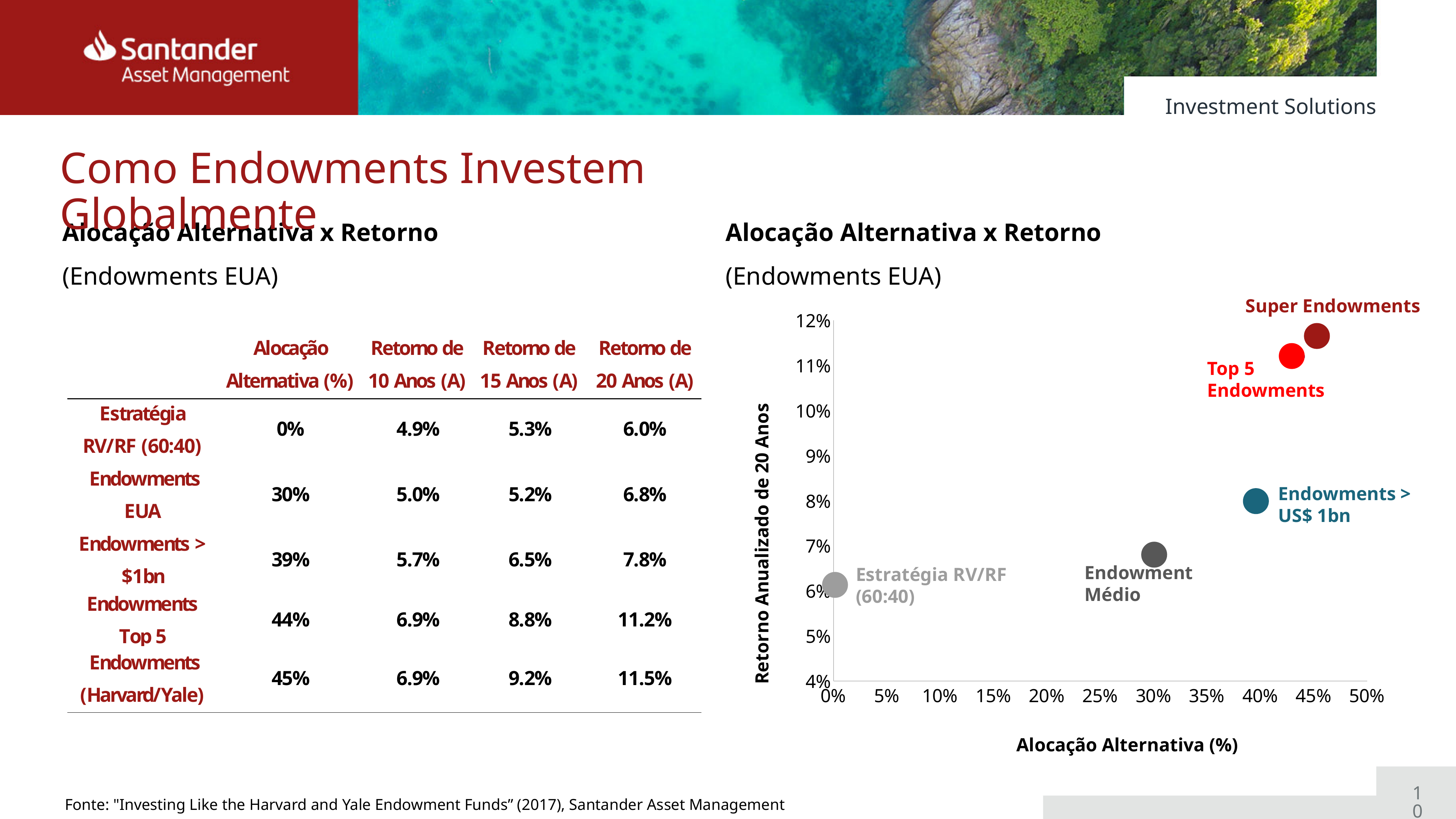
What is the title of the vertical axis of the scatter chart? Retorno Anualizado de 20 Anos In the scatter chart, which point has the lowest 20-year annualized return? Estratégia RV/RF (60:40) In the scatter chart, is the return for Endowments > US$ 1bn greater or less than 7%? greater In the scatter chart, do returns rise or fall as the alternative allocation increases along the x axis? Rise How many data points are plotted in the scatter chart? 5 In the scatter chart, which has the higher 20-year annualized return: Top 5 Endowments or Endowments > US$ 1bn? Top 5 Endowments In the scatter chart, is the alternative allocation for Estratégia RV/RF (60:40) greater or less than 5%? less In the scatter chart, is the alternative allocation for Endowments > US$ 1bn greater or less than 35%? greater In the scatter chart, which point has the highest 20-year annualized return? Super Endowments What kind of chart is shown on the right side of the slide under 'Alocação Alternativa x Retorno (Endowments EUA)'? Scatter chart